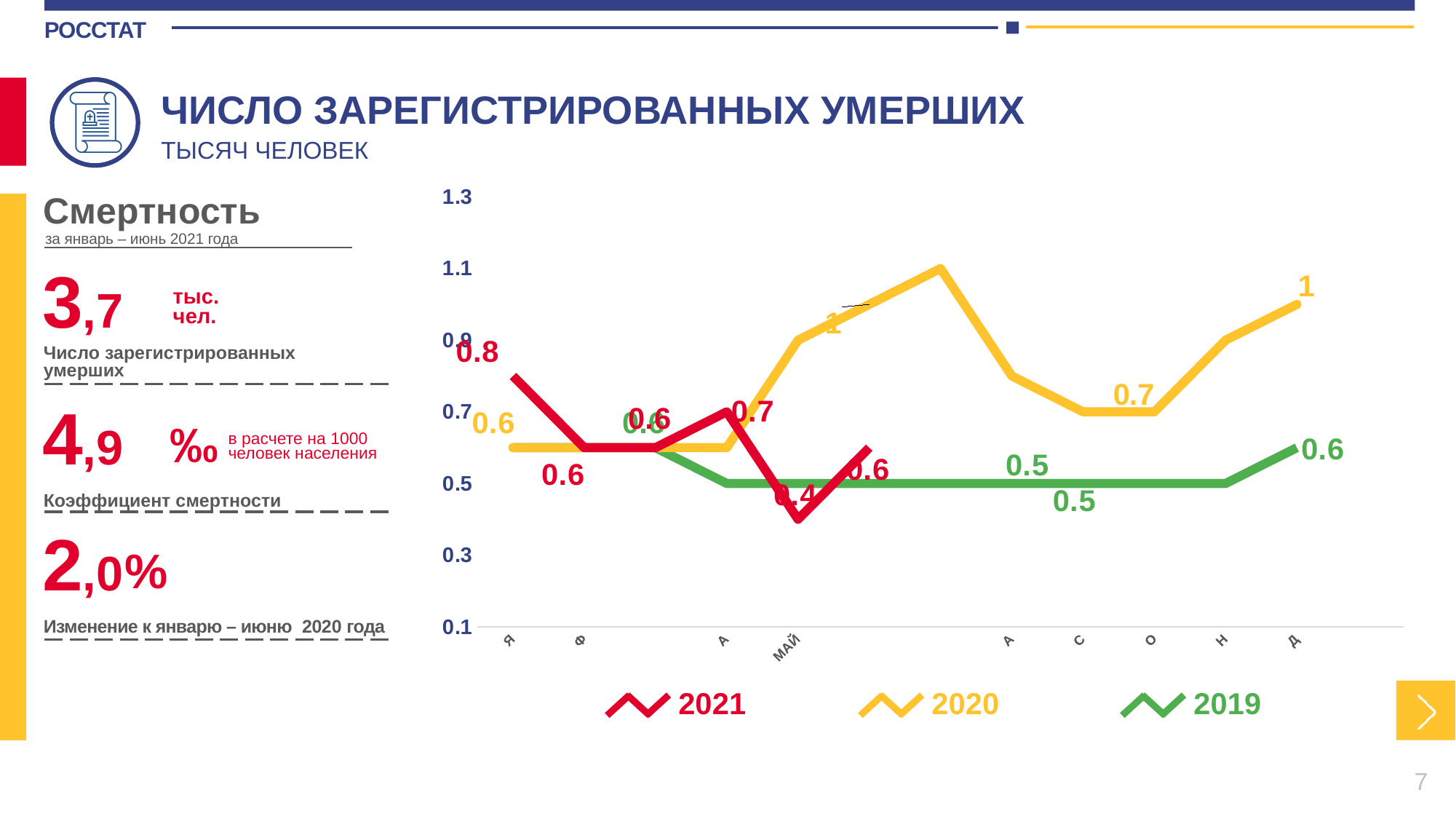
What is the value of the 2019 series in December (Д)? 0.6 Does the 2021 series rise or fall from January to February? fall How many series does the chart legend list? 3 What is the difference between the 2021 values in January and May? 0.4 Which years are listed in the chart legend? 2021, 2020, 2019 What is the value of the 2021 series in May (МАЙ)? 0.4 What kind of chart is shown on the slide? line chart What is the value of the 2021 series in January (Я)? 0.8 In December (Д), which series has the larger value, 2020 or 2019? 2020 In which month does the 2021 series reach its lowest value? May (МАЙ) What is the value of the 2020 series in December (Д)? 1 In which month does the 2021 series reach its highest value? January (Я)